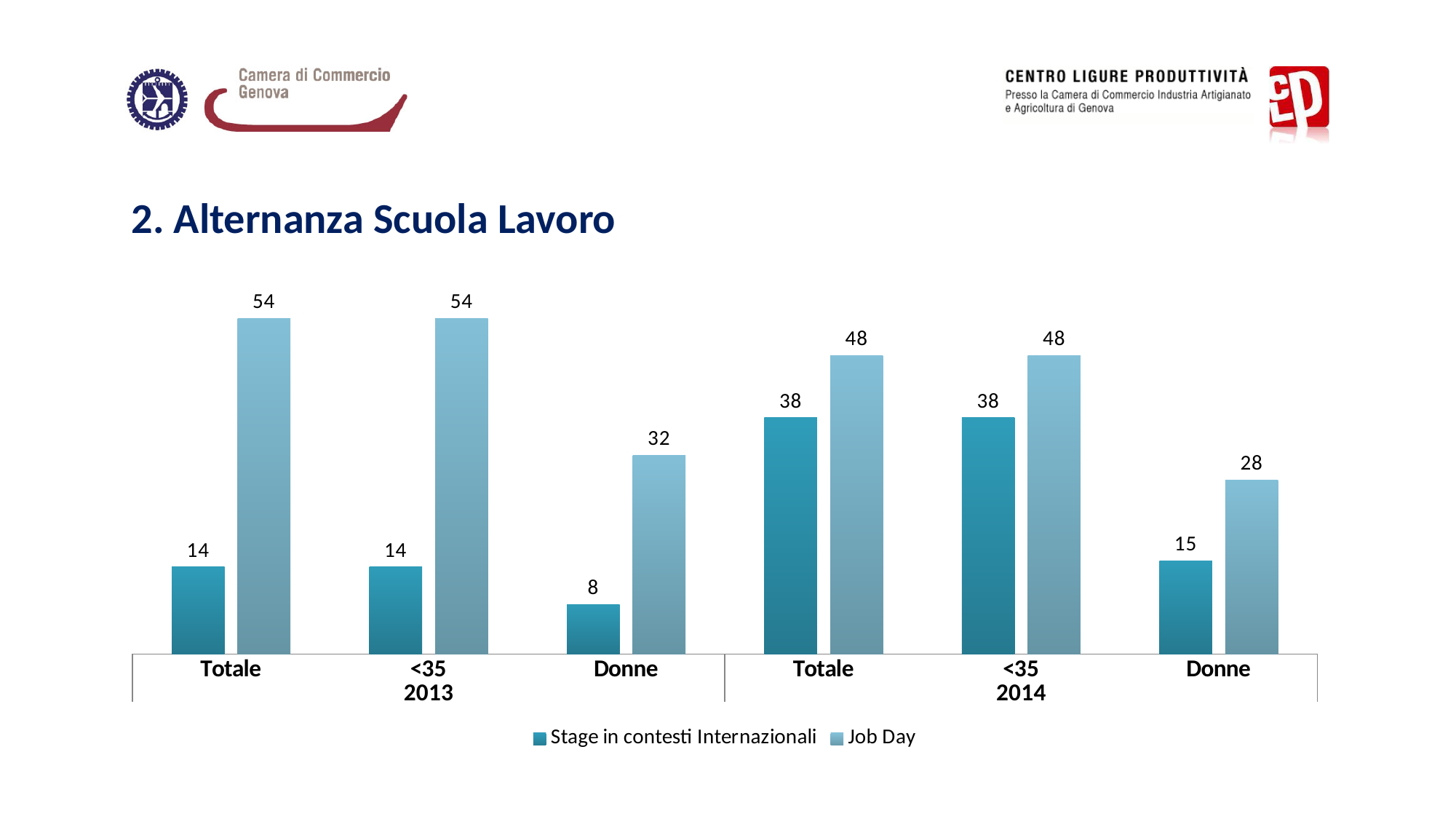
Which category has the lowest Stage in contesti Internazionali value? Donne 2013 What is the value for Stage in contesti Internazionali for <35 in 2014? 38 What is the value for Job Day for Donne in 2014? 28 What is the difference between the Job Day value and the Stage in contesti Internazionali value for Totale in 2014? 10 What is the difference between the Job Day value for Donne in 2013 and for Donne in 2014? 4 What is the title of the slide above the chart? 2. Alternanza Scuola Lavoro How many categories are shown on the x axis? 6 What is the value for Job Day for Totale in 2013? 54 Which is larger, the Stage in contesti Internazionali value for Totale in 2013 or for Totale in 2014? Totale 2014 What is the value for Stage in contesti Internazionali for Donne in 2013? 8 What kind of chart is shown on the slide? Bar chart How many series does the legend list? 2